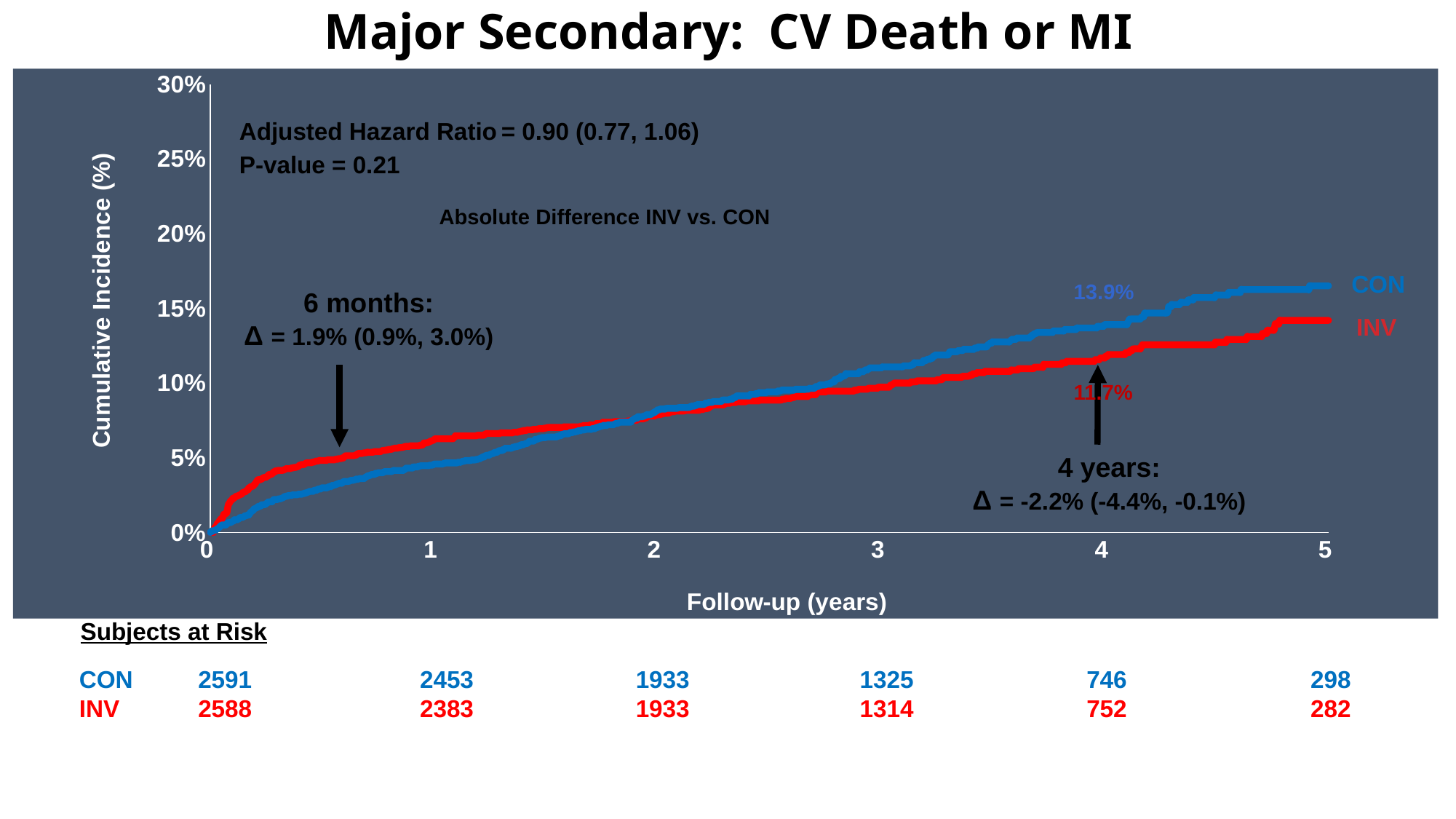
What is the difference between the CON and INV cumulative incidence at 4 years? 2.2% How many CON subjects are at risk at year 0? 2591 Do the cumulative incidence curves rise or fall over the follow-up years? rise Is the cumulative incidence for CON at 5 years greater or less than 15%? greater What is the cumulative incidence for CON at 4 years? 13.9% Is the cumulative incidence for INV at 5 years greater or less than 15%? less How many series (groups) are plotted on the chart? 2 At 4 years, which group has the higher cumulative incidence, CON or INV? CON At 6 months, which curve is higher, CON or INV? INV What is the cumulative incidence for INV at 4 years? 11.7% What kind of chart is shown on the slide? line chart What is the adjusted hazard ratio shown on the chart? 0.90 (0.77, 1.06)